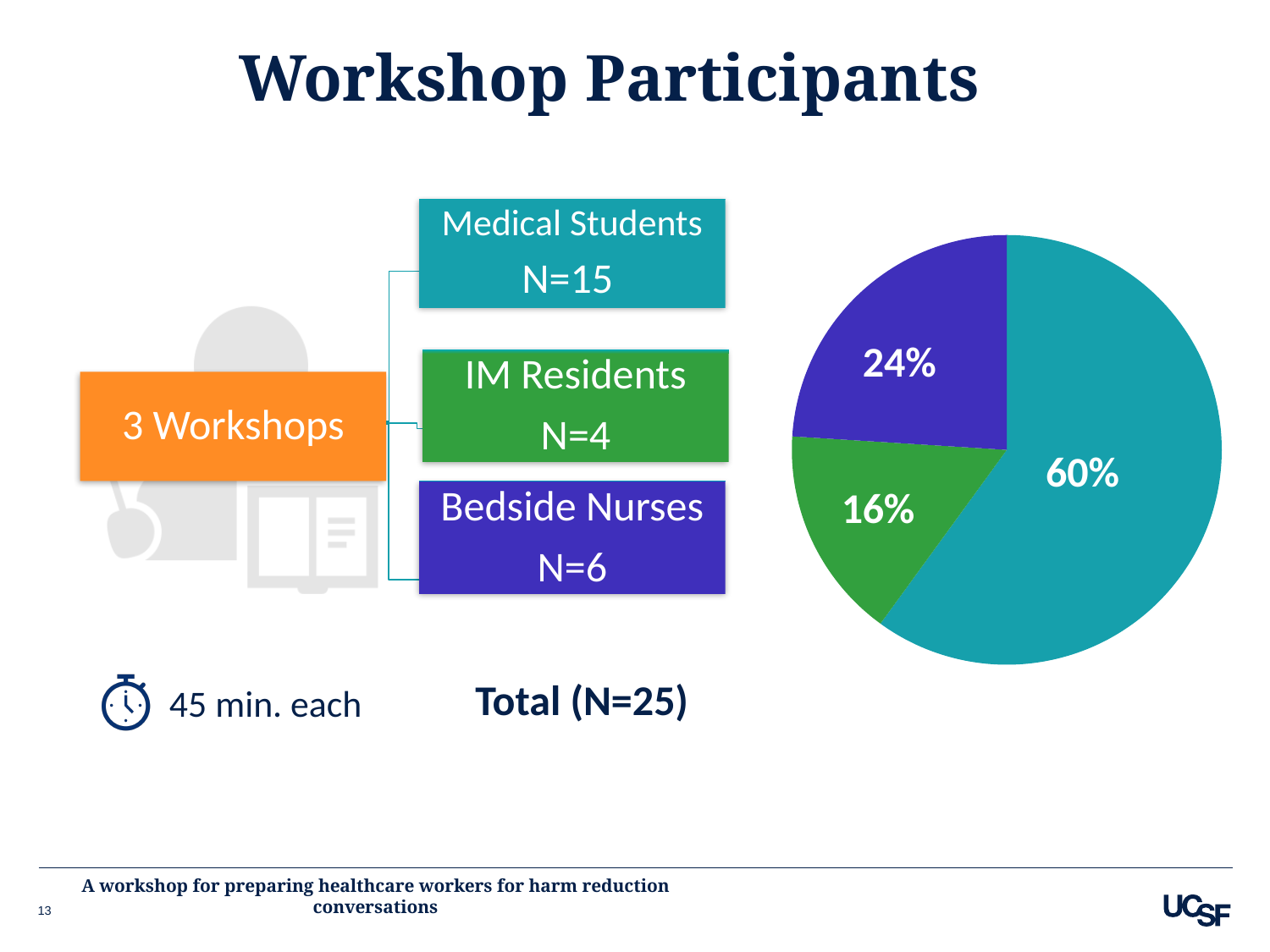
Which slice of the pie chart is larger, the purple one or the green one? the purple one (24%) How many slices does the pie chart have? 3 What is the difference between the largest slice (60%) and the purple slice (24%) in the pie chart? 36% What share of the pie chart corresponds to Medical Students (the teal slice matching the Medical Students box)? 60% What percentage is labelled on the teal slice of the pie chart? 60% What colour is the largest slice of the pie chart? teal What percentage is labelled on the green slice of the pie chart? 16% What is the smallest share shown in the pie chart? 16% What is the largest share shown in the pie chart? 60% What is the difference between the purple slice (24%) and the green slice (16%) in the pie chart? 8% What kind of chart is shown on the slide? pie chart What percentage is labelled on the purple slice of the pie chart? 24%